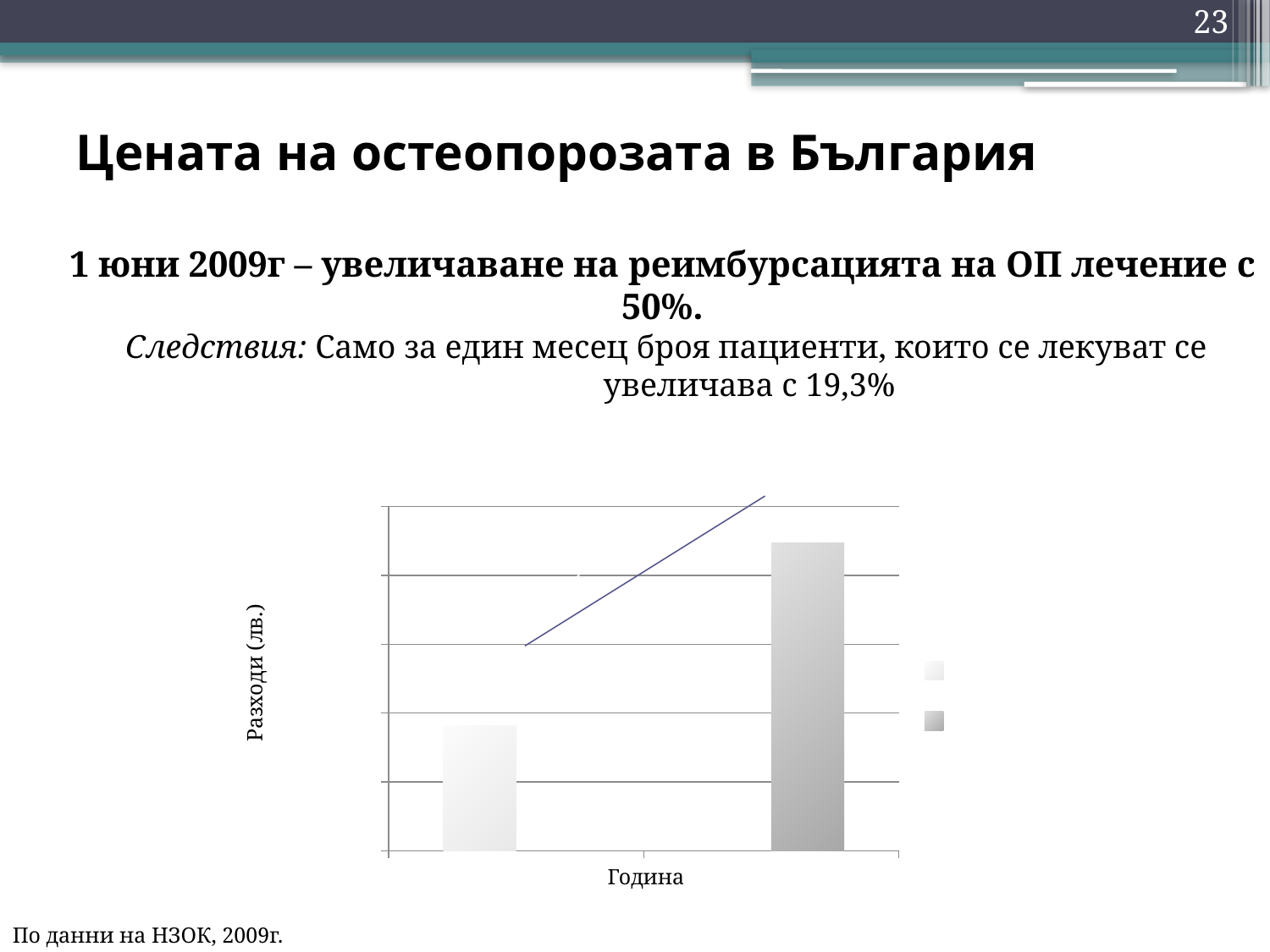
What is the title of the chart's horizontal axis? Година What kind of chart is shown on the slide? bar chart Do the bar values rise or fall from left to right along the x axis? rise How many entries does the chart's legend list? 2 Which bar is taller, the light-coloured bar on the left or the dark-coloured bar on the right? the dark-coloured bar on the right What is the title of the chart's vertical axis? Разходи (лв.) How many bars are plotted in the chart? 2